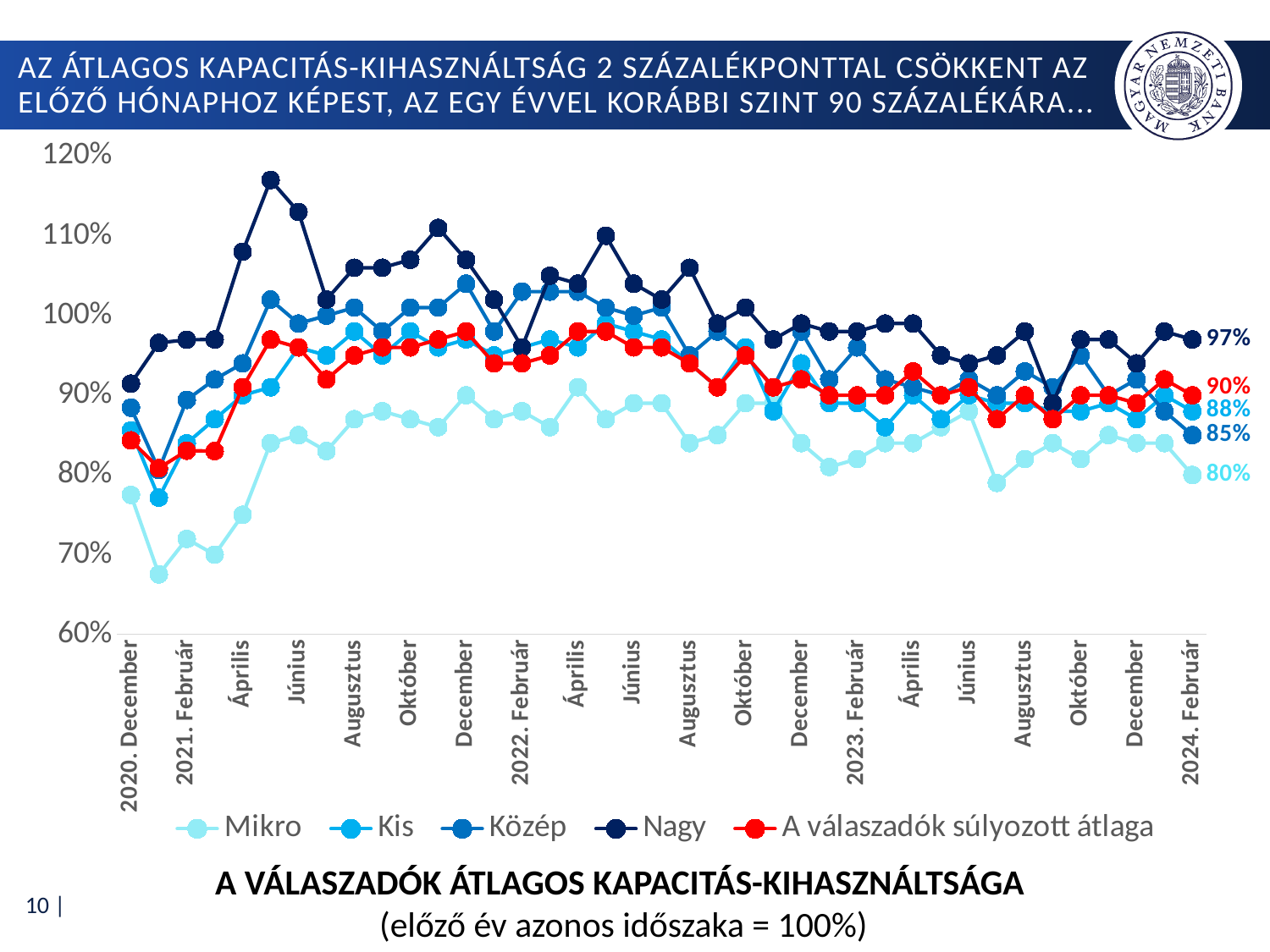
At 2024. Február, which is larger: the Kis value or the Közép value? Kis What is the value of the Mikro series at 2024. Február? 80% What is the value of 'A válaszadók súlyozott átlaga' at 2024. Február? 90% What is the value of the Nagy series at 2024. Február? 97% How many series does the legend list? 5 Which series has the lowest value at 2024. Február? Mikro What is the value of the Kis series at 2024. Február? 88% What type of chart is shown on the slide? line chart Is the value for Mikro at 2020. December greater or less than 80%? less At 2024. Február, what is the difference between the Nagy value and the Mikro value? 17 percentage points Which series has the highest value at 2024. Február? Nagy Does the Nagy series overall rise or fall from 2021. Június to 2024. Február? fall